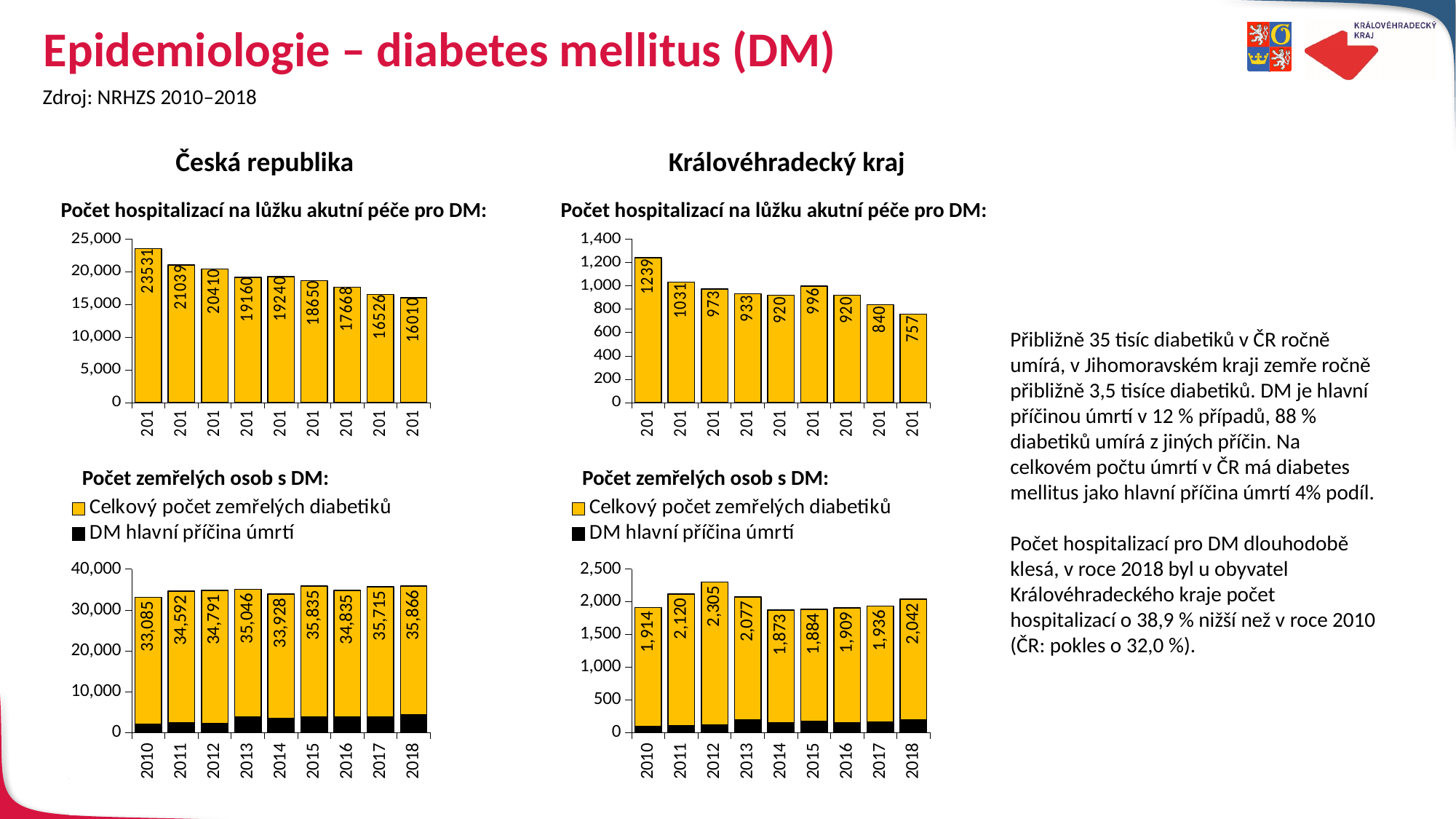
In the bottom-left chart (Česká republika, Počet zemřelých osob s DM), which year has the lowest labelled value? 2010 How many series does the legend of the bottom-left chart (Počet zemřelých osob s DM) list? 2 In the bottom-right chart (Královéhradecký kraj, Počet zemřelých osob s DM), which year has the larger labelled value, 2011 or 2018? 2011 In the bottom-right chart (Královéhradecký kraj, Počet zemřelých osob s DM), which year has the highest labelled value? 2012 In the top-right chart (Královéhradecký kraj, Počet hospitalizací), what is the value of the last bar? 757 In the top-right chart (Královéhradecký kraj, Počet hospitalizací), what is the difference between the first bar (1239) and the last bar (757)? 482 In the bottom-right chart (Královéhradecký kraj, Počet zemřelých osob s DM), what is the difference between the labelled values for 2012 and 2014? 432 In the top-left chart (Česká republika, Počet hospitalizací na lůžku akutní péče pro DM), what is the value of the first bar? 23531 In the top-right chart (Královéhradecký kraj, Počet hospitalizací na lůžku akutní péče pro DM), what is the highest value shown? 1239 In the top-left chart (Česká republika, Počet hospitalizací), what is the lowest value shown? 16010 In the bottom-left chart (Česká republika, Počet zemřelých osob s DM), what value is labelled for 2018? 35,866 In the top-left chart (Česká republika, Počet hospitalizací), do the values generally rise or fall from left to right? fall